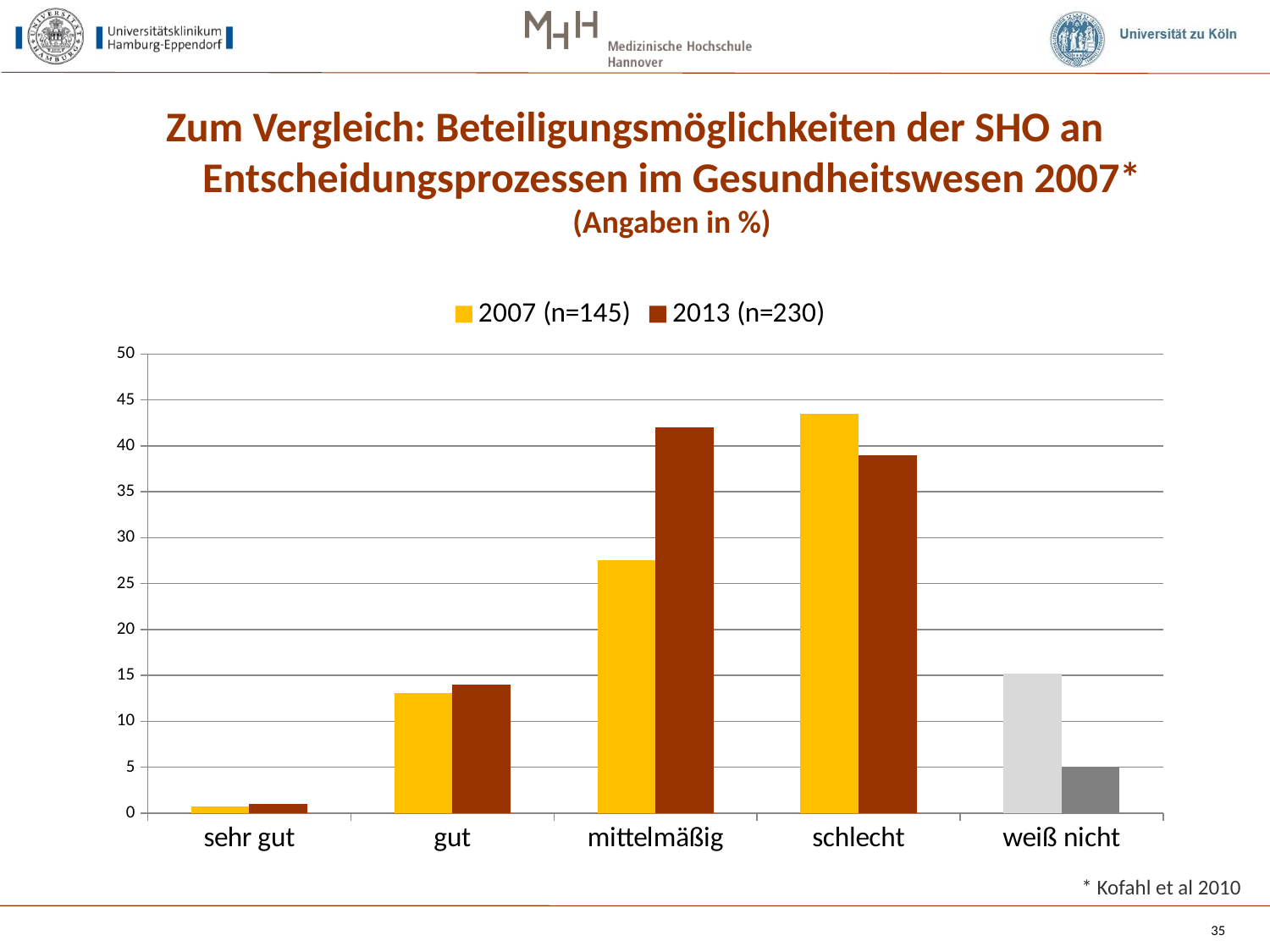
Which category has the highest value for the 2007 (n=145) series? schlecht Is the value for weiß nicht in the 2013 (n=230) series greater or less than 10? less Is the value for mittelmäßig in the 2007 (n=145) series greater or less than 25? greater For the category schlecht, which series has the larger value, 2007 (n=145) or 2013 (n=230)? 2007 (n=145) How many categories are shown on the x axis? 5 What are the two entries listed in the chart legend? 2007 (n=145) and 2013 (n=230) For the category mittelmäßig, which series has the larger value, 2007 (n=145) or 2013 (n=230)? 2013 (n=230) How many series does the legend list? 2 Is the value for mittelmäßig in the 2013 (n=230) series greater or less than 40? greater What kind of chart is shown on the slide? bar chart Which category has the highest value for the 2013 (n=230) series? mittelmäßig Which category has the lowest value for the 2013 (n=230) series? sehr gut